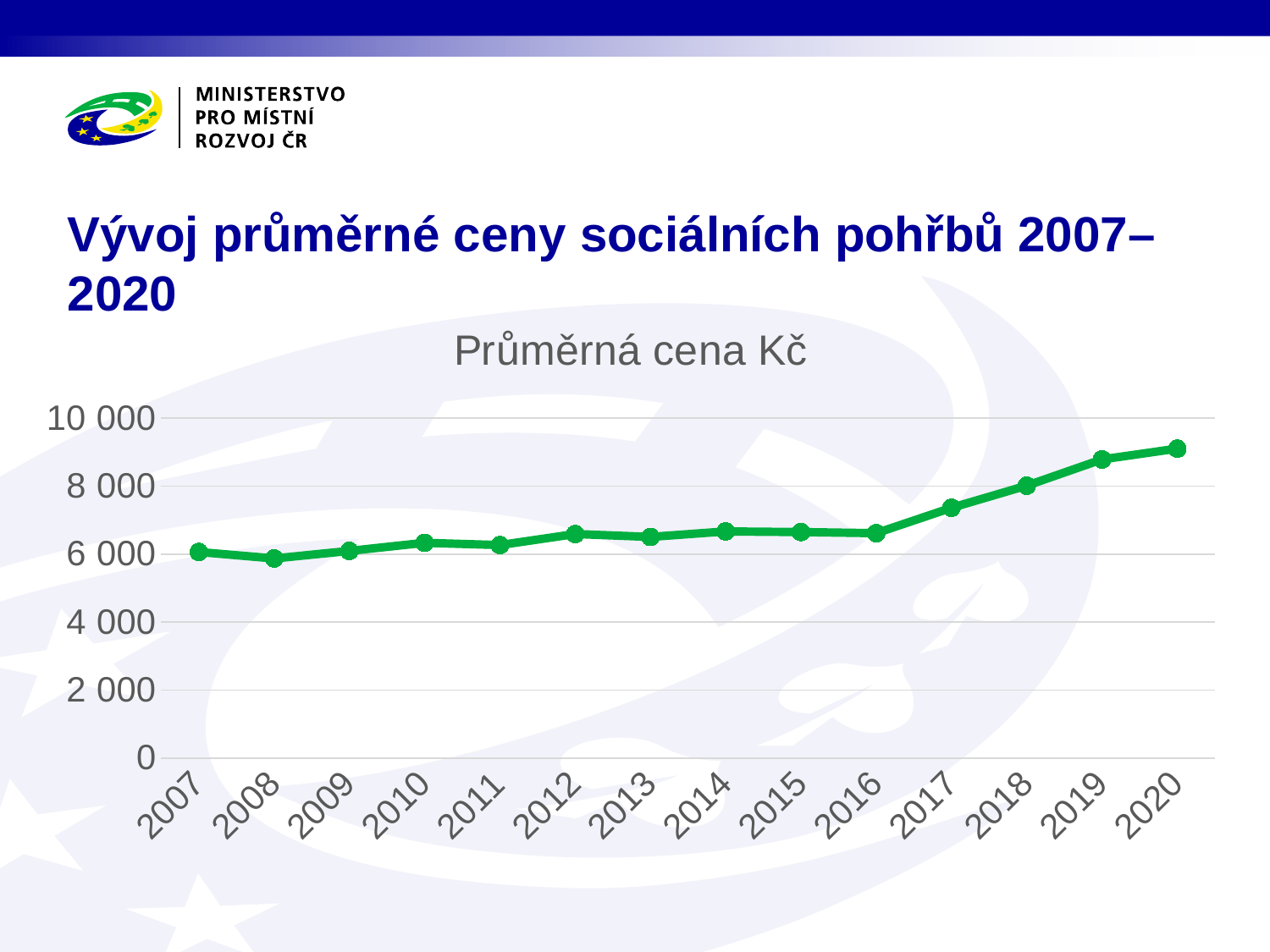
Is the value for 2012 greater or less than 8 000? less Which year has the larger value, 2012 or 2017? 2017 What kind of chart is shown on the slide? line chart Is the value for 2008 greater or less than 6 000? less Is the value for 2020 greater or less than 8 000? greater Which year has the larger value, 2007 or 2020? 2020 Which year has the highest average price in the chart? 2020 How many years are plotted on the x axis of the chart? 14 Does the average price generally rise or fall from 2016 to 2020? rise What is the title of the chart? Průměrná cena Kč Which year has the lowest average price in the chart? 2008